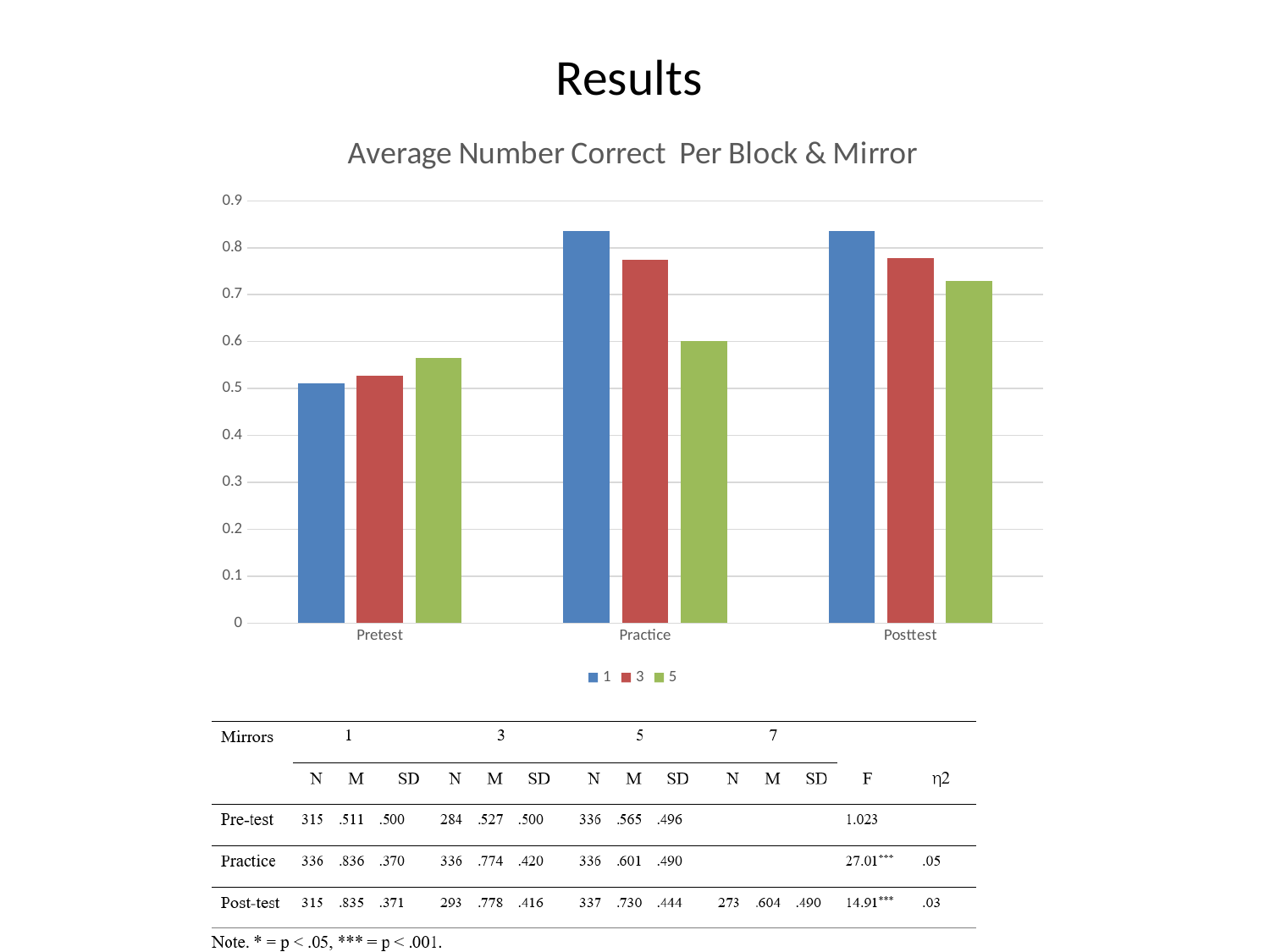
Is the value for series 5 in the Practice category greater or less than 0.7? less Is the value for series 1 in the Practice category greater or less than 0.8? greater Do the values for series 5 rise or fall from Pretest to Posttest? rise Which is larger for series 5: the Practice value or the Posttest value? Posttest Which series has the highest bar in the Pretest category? 5 Which series has the highest bar in the Practice category? 1 Which series has the lowest bar in the Posttest category? 5 How many categories are shown on the x axis of the chart? 3 How many series does the chart legend list? 3 Is the value for series 5 in the Posttest category greater or less than 0.7? greater What is the title of the chart? Average Number Correct Per Block & Mirror What type of chart is shown on the slide? bar chart